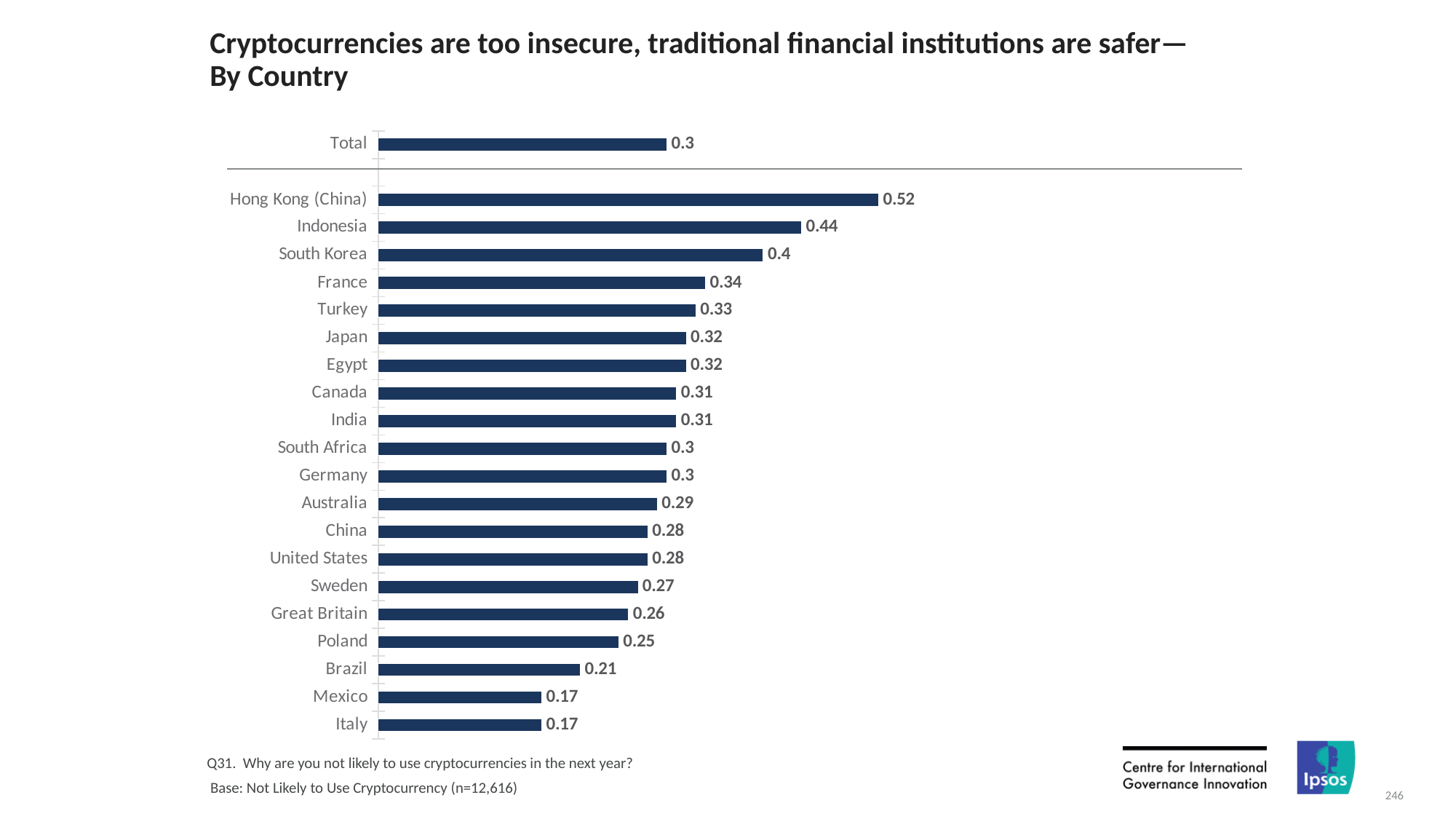
What kind of chart is shown on the slide? Bar chart What is the value for Brazil? 0.21 Which country has the highest value? Hong Kong (China) What is the value for Hong Kong (China)? 0.52 How many countries are listed below the Total bar? 20 What is the difference between the values for Hong Kong (China) and Italy? 0.35 What is the difference between the values for Indonesia and South Korea? 0.04 What is the value for Poland? 0.25 What is the base size (n) stated at the bottom of the slide? n=12,616 Which is larger, the value for France or the value for Turkey? France What is the value for the Total bar? 0.3